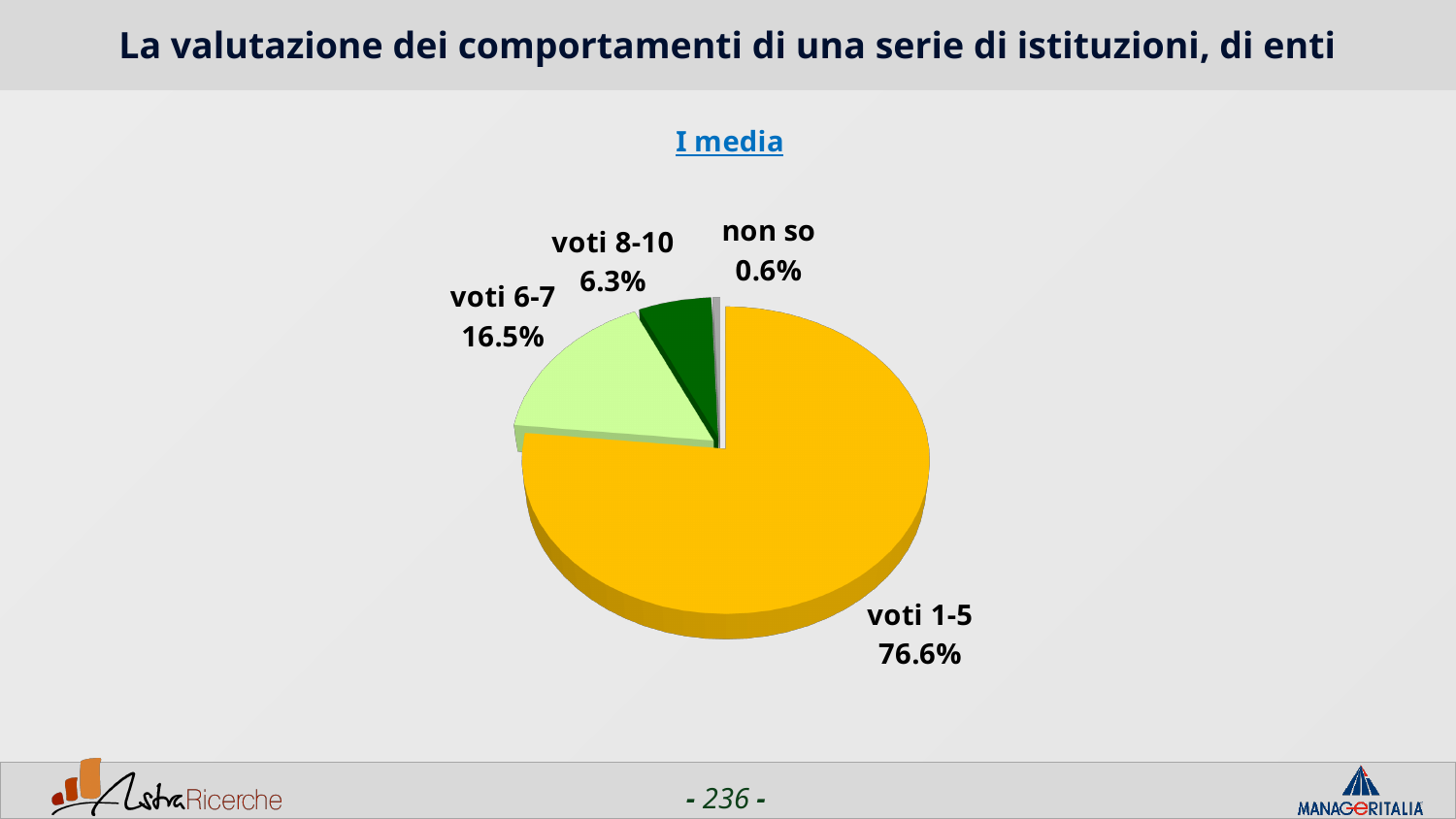
Which category has the largest slice? voti 1-5 How many slices does the pie chart have? 4 What is the title of the chart? I media Which category has the smallest slice? non so What is the value for 'voti 8-10'? 6.3% Which is larger, the value for 'voti 8-10' or the value for 'non so'? voti 8-10 What is the difference between the values for 'voti 1-5' and 'voti 6-7'? 60.1% What kind of chart is shown on the slide? pie chart What is the value for 'voti 6-7'? 16.5% What is the value for 'non so'? 0.6% What is the value for 'voti 1-5'? 76.6% What is the difference between the values for 'voti 6-7' and 'voti 8-10'? 10.2%